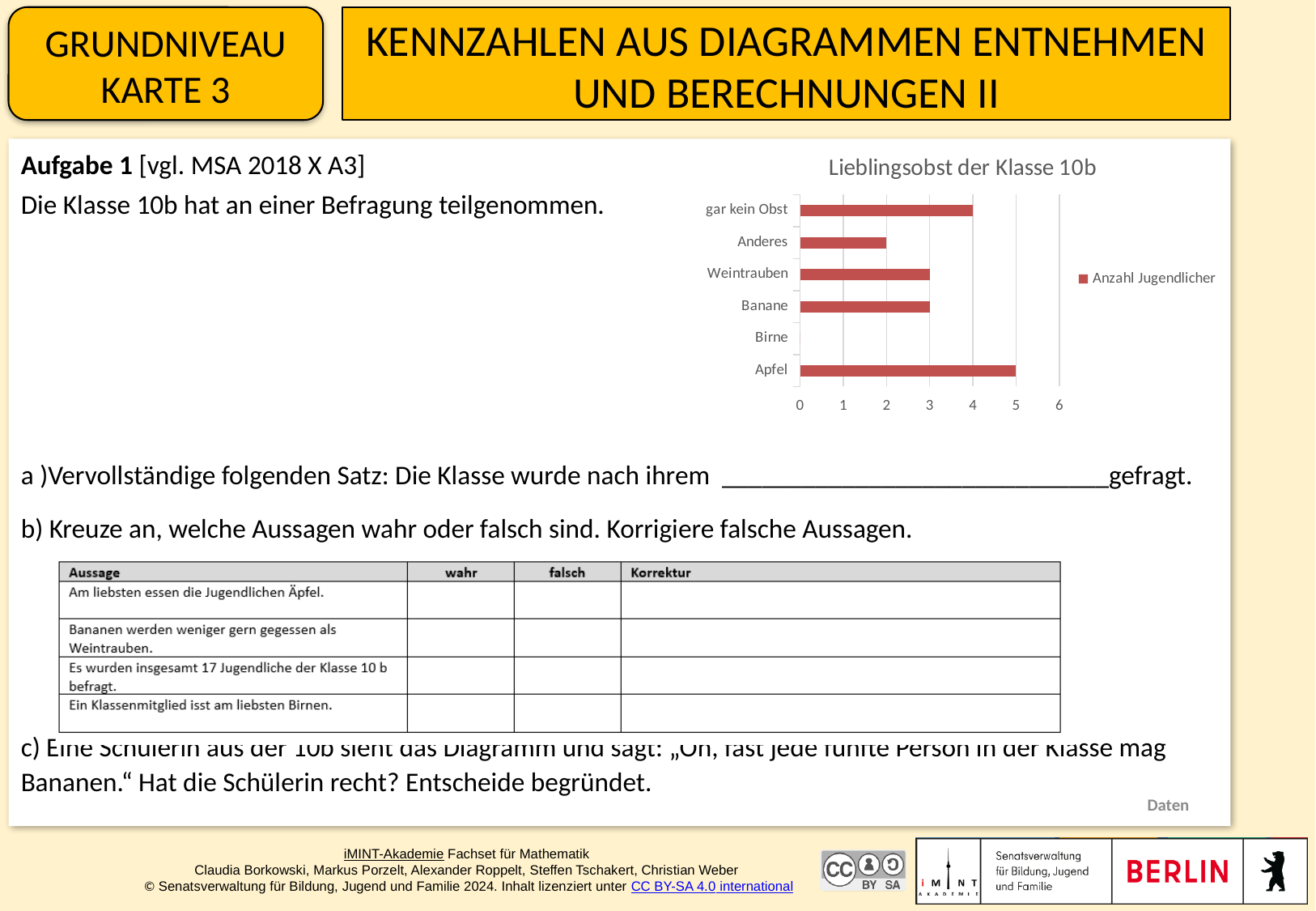
How many categories are shown in the chart? 6 What is the value for gar kein Obst in the chart? 4 What is the difference between the values for Apfel and Anderes? 3 Which category has the lowest value in the chart? Birne Which category has the highest value in the chart? Apfel What is the value for Banane in the chart? 3 Which is larger, the value for gar kein Obst or the value for Weintrauben? gar kein Obst What kind of chart is shown on the slide? bar chart How many series does the legend list? 1 What is the title of the chart? Lieblingsobst der Klasse 10b What is the value for Apfel in the chart? 5 What is the value for Anderes in the chart? 2